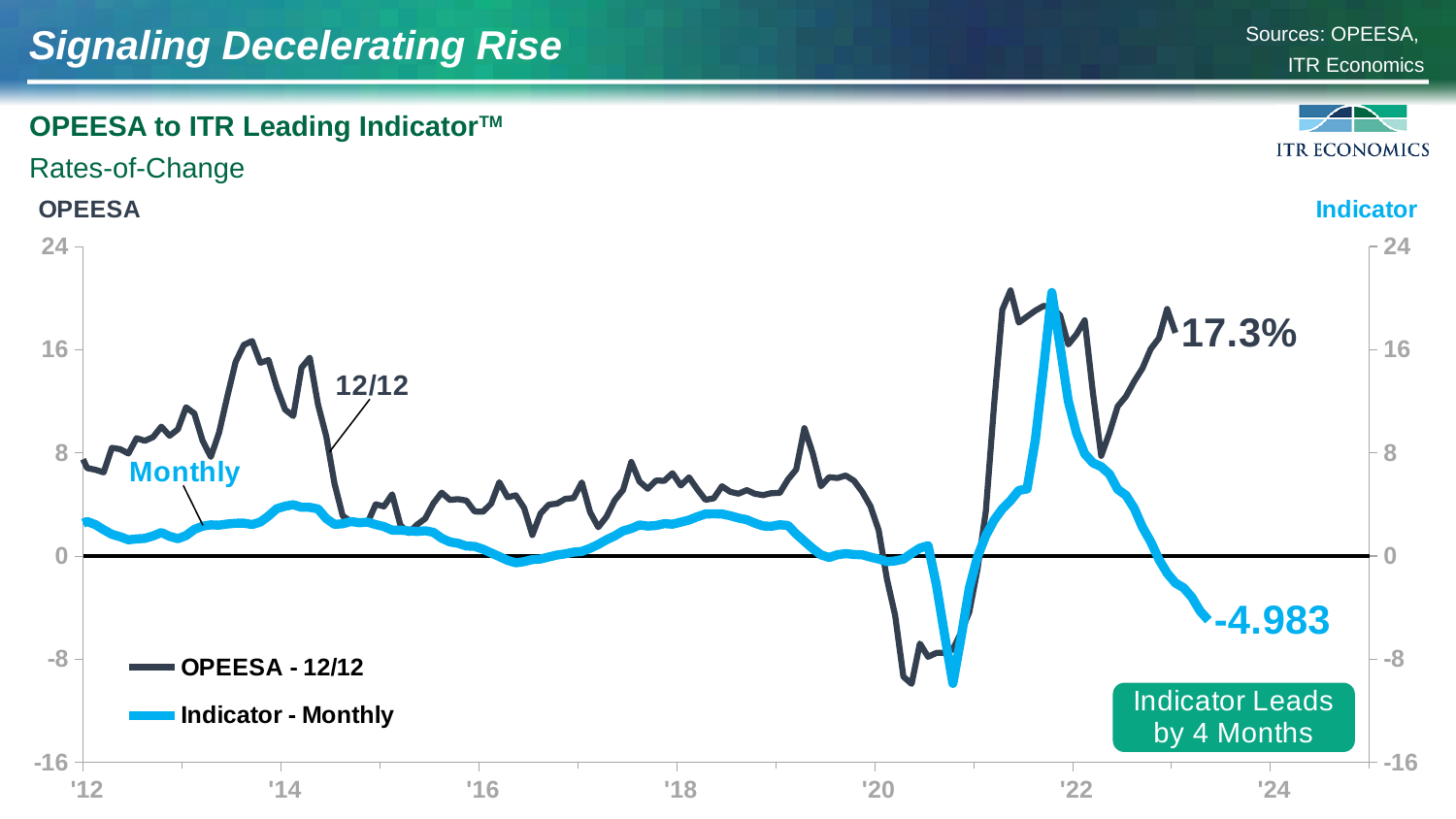
What kind of chart is shown on the slide? line chart Which is larger, the latest labeled OPEESA - 12/12 value or the latest labeled Indicator - Monthly value? OPEESA - 12/12 How many year labels are shown on the x axis? 7 Is the lowest point of the OPEESA - 12/12 line greater or less than 0? less Is the latest labeled Indicator - Monthly value greater or less than 0? less According to the callout box, by how many months does the Indicator lead? 4 months Does the Indicator - Monthly line rise or fall from its peak near '22 to the end of the series? fall What is the title of the chart? OPEESA to ITR Leading Indicator™ What is the latest labeled value of the Indicator - Monthly line? -4.983 What is the latest labeled value of the OPEESA - 12/12 line? 17.3% How many series does the legend list? 2 Is the latest labeled OPEESA - 12/12 value greater or less than 16? greater